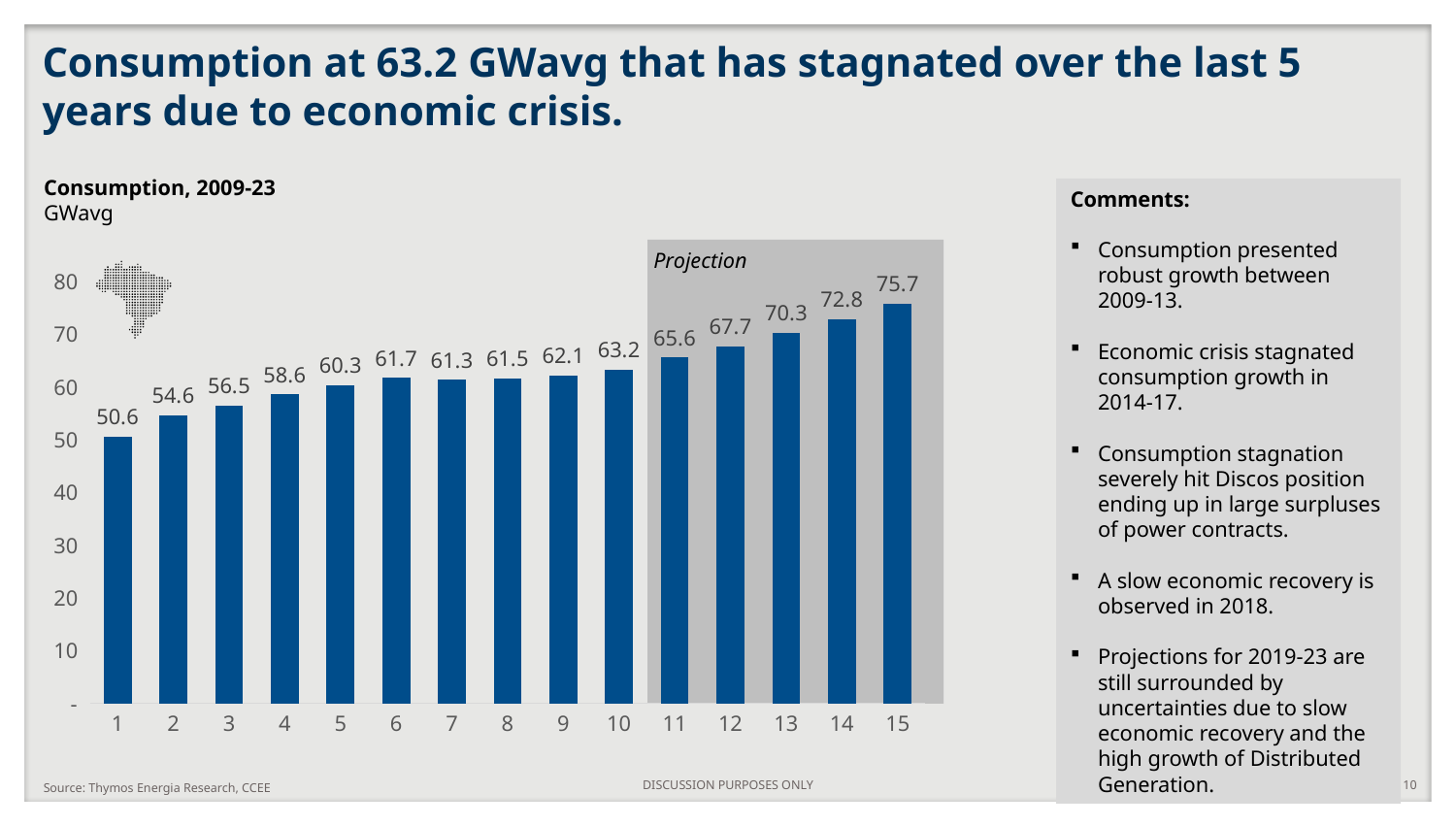
What is the value for category 1 in the Consumption, 2009-23 chart? 50.6 What is the value for category 10 in the Consumption, 2009-23 chart? 63.2 What unit is shown under the title of the Consumption, 2009-23 chart? GWavg What is the difference between the values for category 10 and category 5 in the Consumption, 2009-23 chart? 2.9 Which is larger in the Consumption, 2009-23 chart: the value for category 6 or the value for category 9? category 9 Which category has the lowest value in the Consumption, 2009-23 chart? 1 Which category has the highest value in the Consumption, 2009-23 chart? 15 Is the value for category 3 in the Consumption, 2009-23 chart greater or less than 60? less What is the value for category 15 in the Consumption, 2009-23 chart? 75.7 What kind of chart is the Consumption, 2009-23 chart? bar chart What is the difference between the values for category 15 and category 1 in the Consumption, 2009-23 chart? 25.1 How many bars are plotted in the Consumption, 2009-23 chart? 15